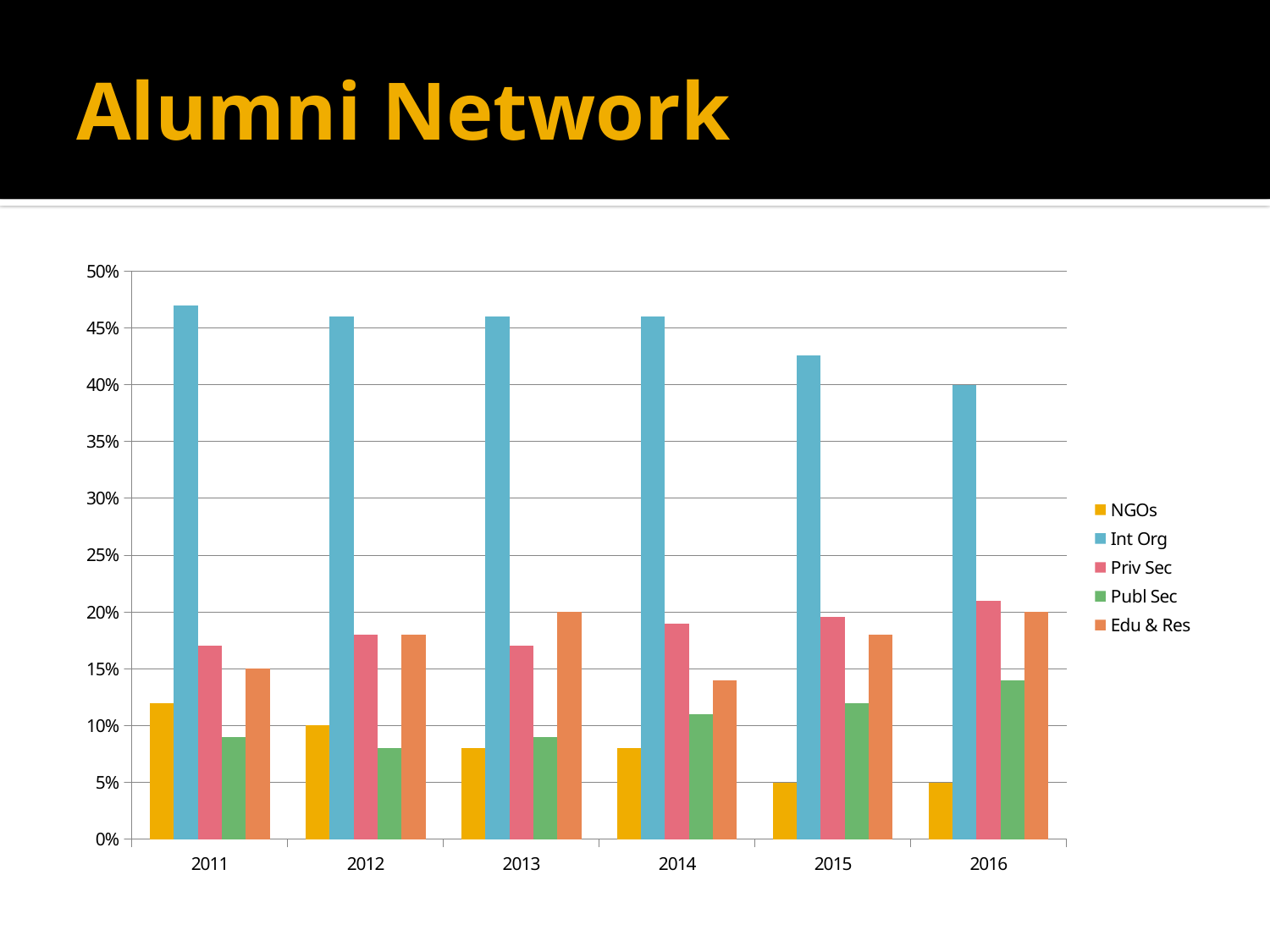
Which series has the highest value in 2014? Int Org What is the value for Int Org in 2016? 40% How many years are shown on the x axis? 6 How many series does the legend list? 5 Is the value for Publ Sec in 2012 greater or less than 10%? less What kind of chart is shown on the slide? bar chart Is the value for Int Org in 2011 greater or less than 45%? greater Do the Int Org values rise or fall from 2011 to 2016? fall What is the value for NGOs in 2012? 10% In 2016, which is larger: Priv Sec or Publ Sec? Priv Sec Which series has the lowest value in 2016? NGOs What is the value for Edu & Res in 2013? 20%